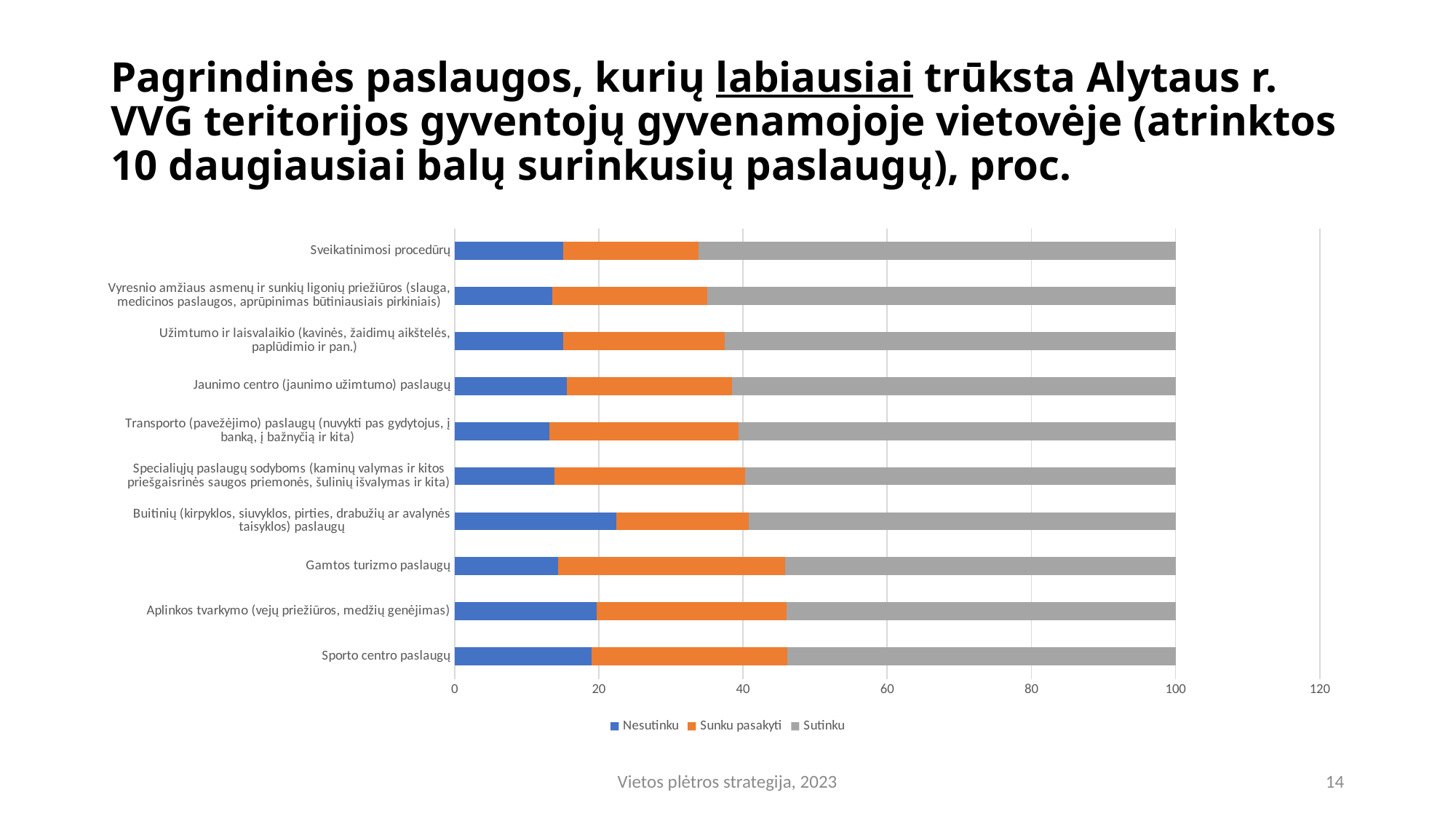
Is the Nesutinku value for Buitinių (kirpyklos, siuvyklos, pirties, drabužių ar avalynės taisyklos) paslaugų greater or less than 20? greater How many series does the legend list? 3 What are the three series named in the legend? Nesutinku, Sunku pasakyti, Sutinku Which series is shown in grey? Sutinku Which category has the largest Nesutinku segment? Buitinių (kirpyklos, siuvyklos, pirties, drabužių ar avalynės taisyklos) paslaugų Is the Nesutinku value for Sveikatinimosi procedūrų greater or less than 20? less What is the total of the stacked bar for Sveikatinimosi procedūrų? 100 What kind of chart is shown on the slide? Stacked bar chart How many service categories are plotted on the chart? 10 What is the total of the stacked bar for Sporto centro paslaugų? 100 Is the Sutinku value for Sveikatinimosi procedūrų greater or less than 60? greater Which has the larger Sunku pasakyti segment: Gamtos turizmo paslaugų or Sveikatinimosi procedūrų? Gamtos turizmo paslaugų